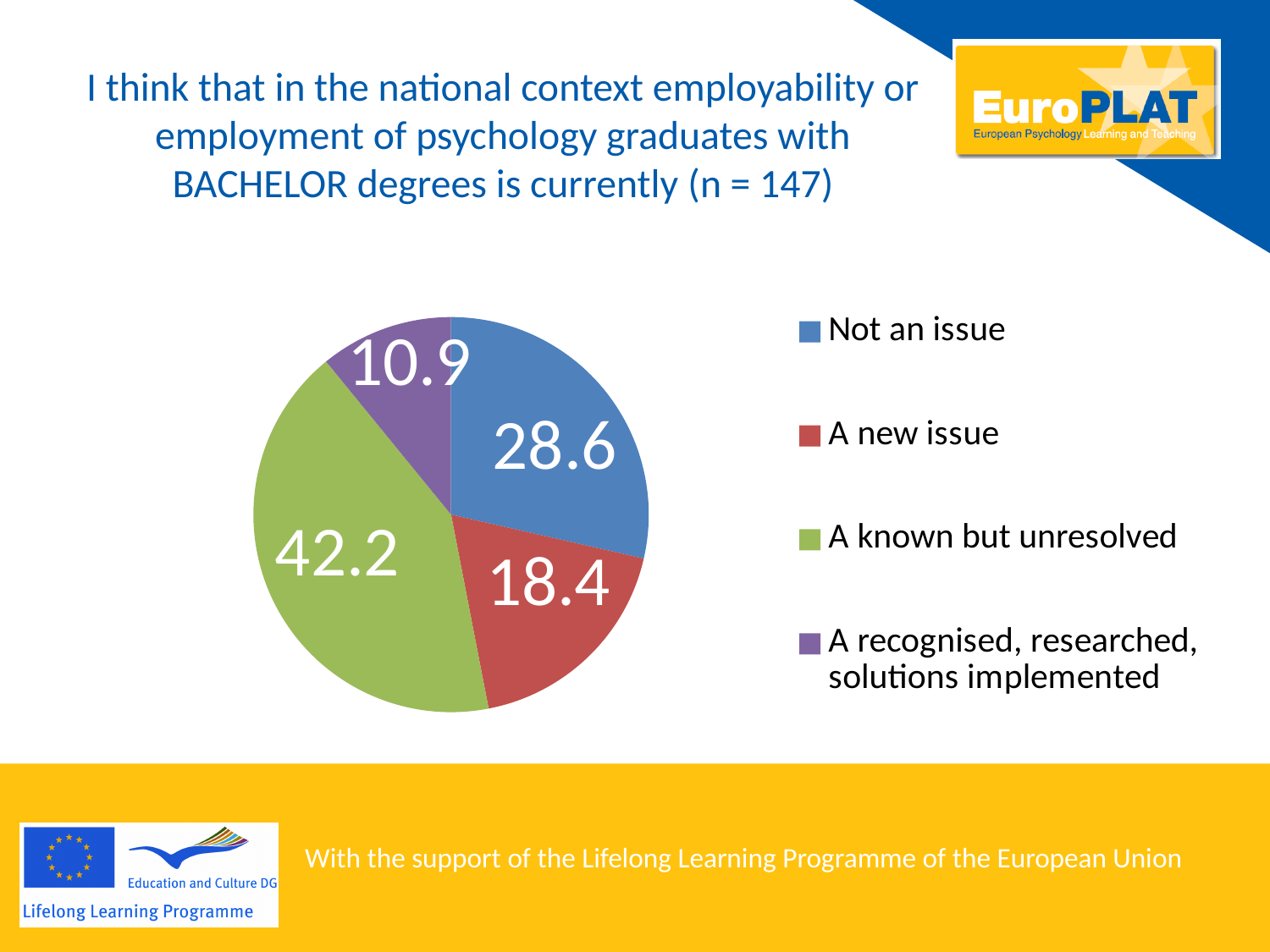
What is the difference between the values for "A known but unresolved" and "Not an issue"? 13.6 How many categories does the pie chart have? 4 What is the difference between the values for "A new issue" and "A recognised, researched, solutions implemented"? 7.5 Which category has the largest slice of the pie? A known but unresolved What is the value for "Not an issue"? 28.6 What is the value for "A new issue"? 18.4 What kind of chart is shown on the slide? pie chart What is the value for "A recognised, researched, solutions implemented"? 10.9 Which category has the smallest slice of the pie? A recognised, researched, solutions implemented What is the value for "A known but unresolved"? 42.2 Which is larger, the value for "Not an issue" or the value for "A new issue"? Not an issue What colour is the slice for "A known but unresolved"? green